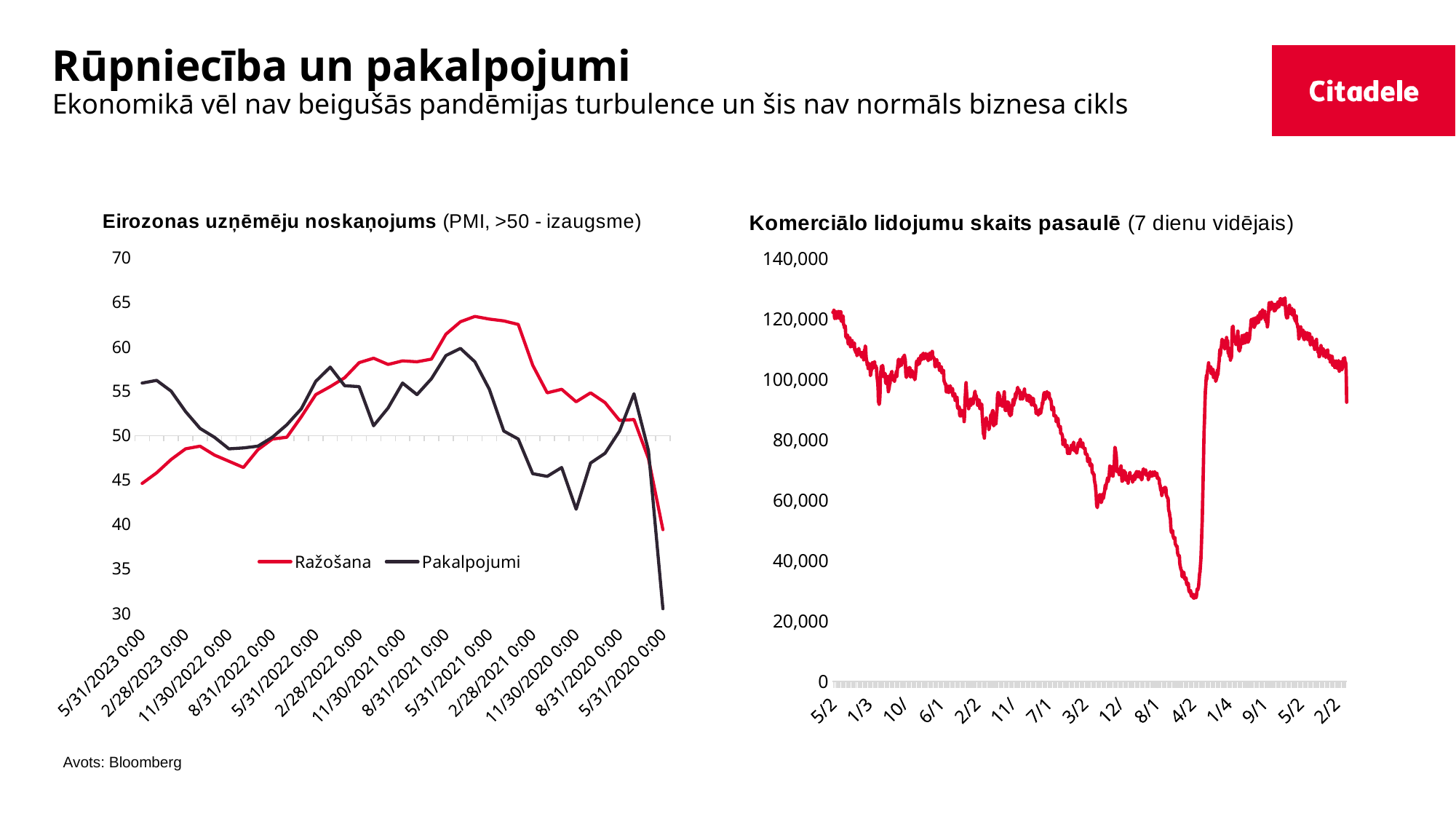
In the 'Eirozonas uzņēmēju noskaņojums' chart, which series is drawn in red? Ražošana What kind of chart is the 'Komerciālo lidojumu skaits pasaulē' chart on the right? line chart In the 'Komerciālo lidojumu skaits pasaulē' chart, is the value at the start of the series (5/2) greater or less than 100,000? greater In the 'Komerciālo lidojumu skaits pasaulē' chart, is the lowest value of the line greater or less than 40,000? less How many series does the legend of the 'Eirozonas uzņēmēju noskaņojums' chart list? 2 What kind of chart is the 'Eirozonas uzņēmēju noskaņojums' chart on the left? line chart In the 'Eirozonas uzņēmēju noskaņojums' chart, which series is higher at 5/31/2021, Ražošana or Pakalpojumi? Ražošana In the 'Eirozonas uzņēmēju noskaņojums' chart, is the Pakalpojumi value at 5/31/2023 greater or less than 50? greater In the 'Eirozonas uzņēmēju noskaņojums' chart, which series is higher at 5/31/2023, Ražošana or Pakalpojumi? Pakalpojumi